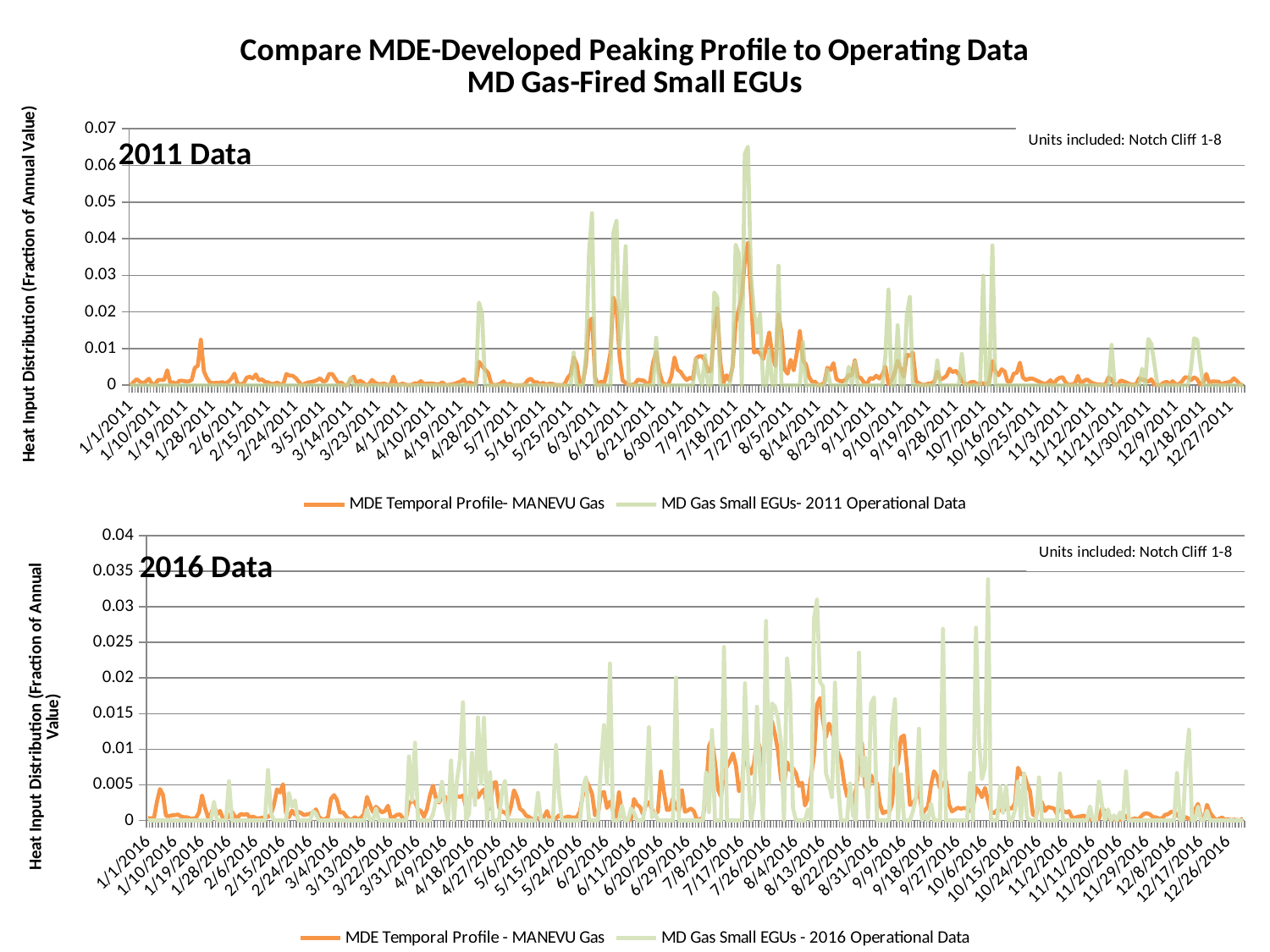
What kind of chart is the 2011 Data chart? line chart In the 2016 Data chart, is the highest peak of the MD Gas Small EGUs - 2016 Operational Data series (around 10/6/2016) greater or less than 0.03? greater How many series does the legend of the 2011 Data chart list? 2 In the 2011 Data chart, is the peak of the MDE Temporal Profile- MANEVU Gas series near 1/28/2011 greater or less than 0.02? less In the 2016 Data chart, is the peak of the MDE Temporal Profile - MANEVU Gas series near 8/13/2016 greater or less than 0.01? greater In the 2011 Data chart, what note appears in the top right corner about the units included? Units included: Notch Cliff 1-8 In the 2011 Data chart, which series reaches the higher maximum value: MDE Temporal Profile- MANEVU Gas or MD Gas Small EGUs- 2011 Operational Data? MD Gas Small EGUs- 2011 Operational Data How many series does the legend of the 2016 Data chart list? 2 In the 2016 Data chart, which series reaches the higher maximum value: MDE Temporal Profile - MANEVU Gas or MD Gas Small EGUs - 2016 Operational Data? MD Gas Small EGUs - 2016 Operational Data In the 2011 Data chart, what are the two legend entries? MDE Temporal Profile- MANEVU Gas; MD Gas Small EGUs- 2011 Operational Data